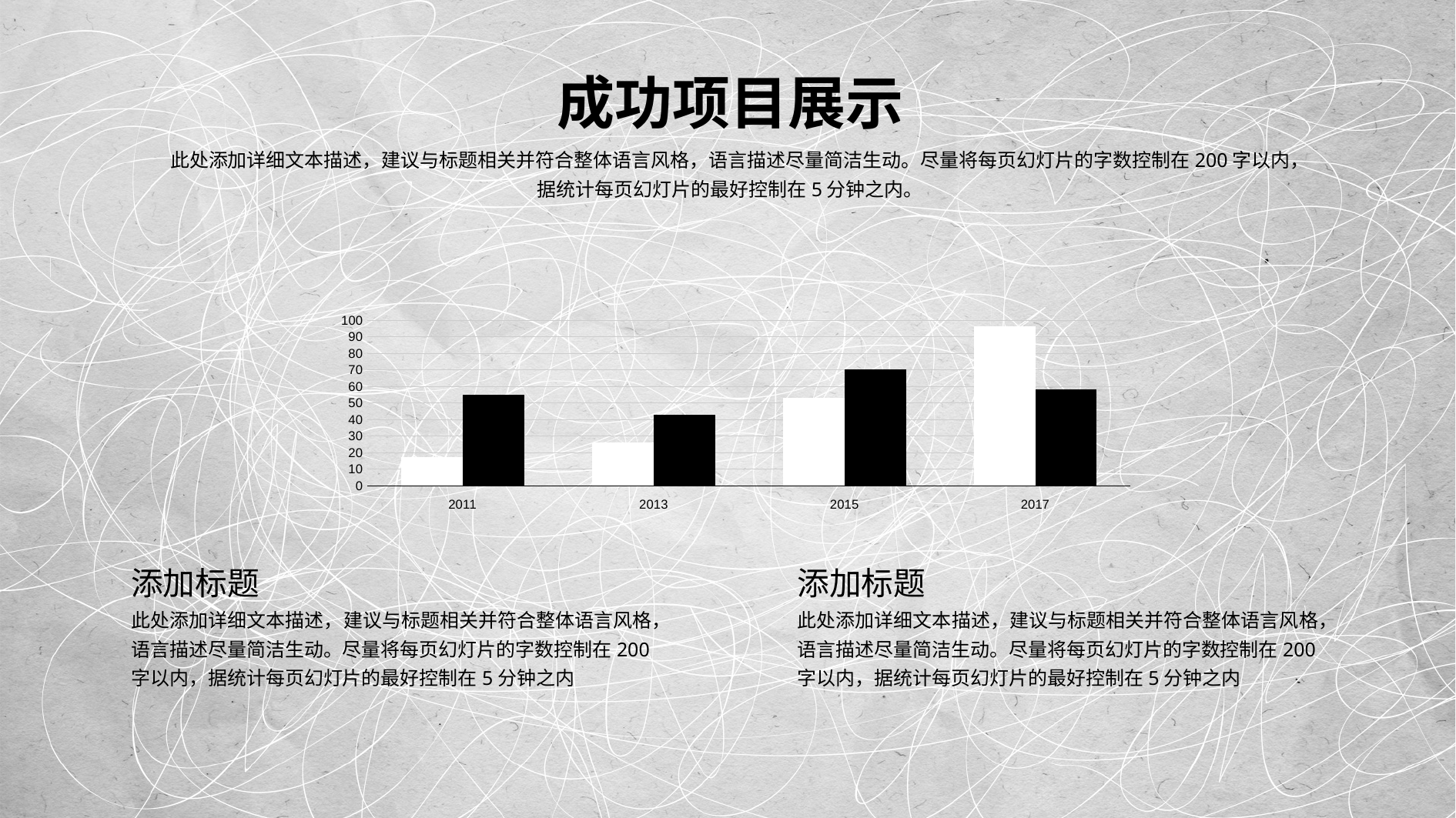
Is the value of the black bar for 2013 greater or less than 50? less In which year is the black bar the tallest? 2015 For 2011, which bar is taller, the white bar or the black bar? the black bar How many bars are plotted for each year in the chart? 2 What kind of chart is shown on the slide? bar chart In which year is the white bar the shortest? 2011 For 2017, which bar is taller, the white bar or the black bar? the white bar How many year categories are shown on the x axis of the chart? 4 Do the white bars rise or fall from 2011 to 2017? rise In which year is the black bar the shortest? 2013 In which year is the white bar the tallest? 2017 Is the value of the white bar for 2017 greater or less than 90? greater